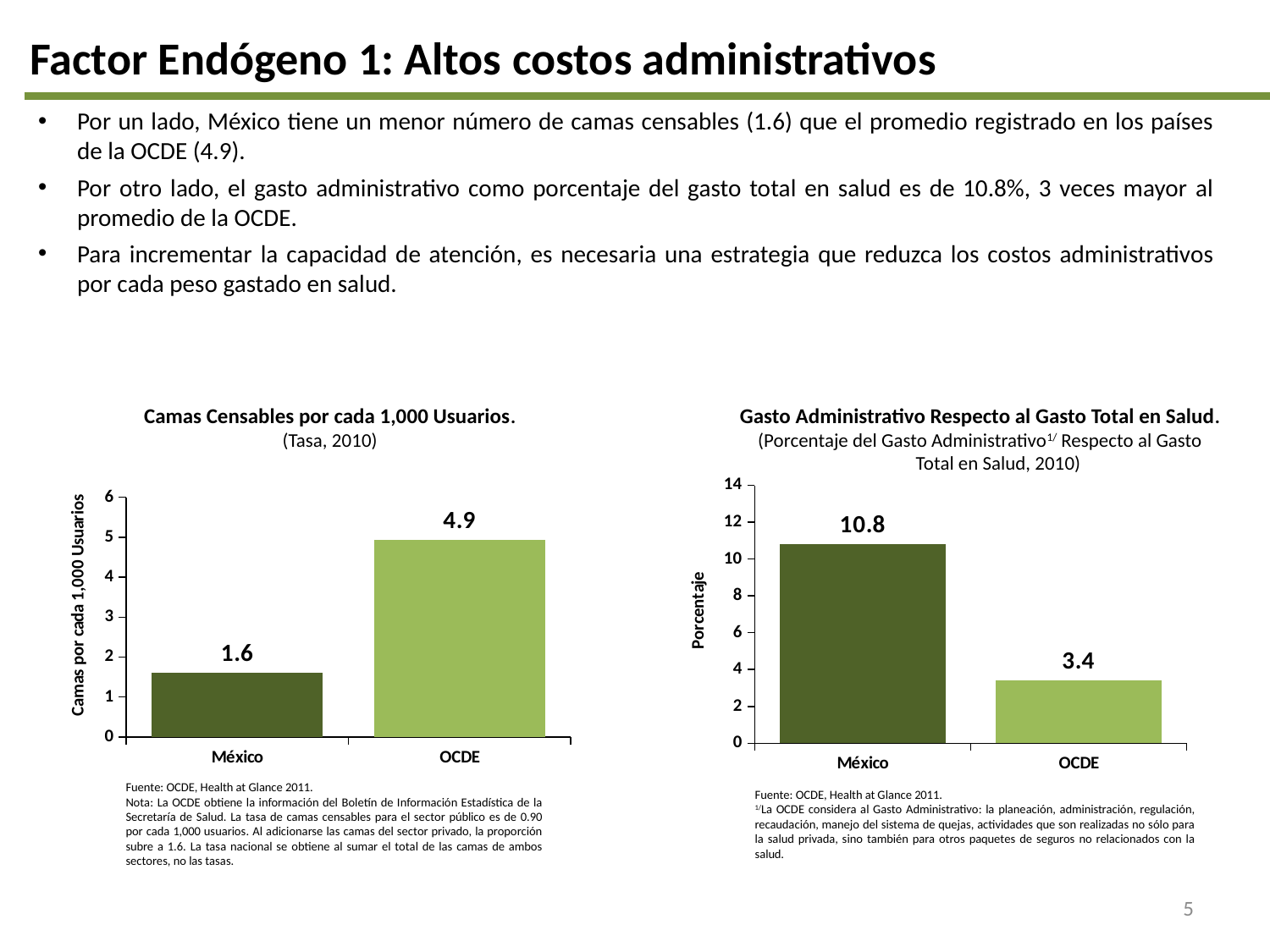
In the 'Gasto Administrativo Respecto al Gasto Total en Salud' chart, which category has the lowest value? OCDE What kind of chart is the 'Gasto Administrativo Respecto al Gasto Total en Salud' chart? bar chart In the 'Camas Censables por cada 1,000 Usuarios' chart, what is the value for OCDE? 4.9 How many categories are shown in the 'Camas Censables por cada 1,000 Usuarios' chart? 2 In the 'Gasto Administrativo Respecto al Gasto Total en Salud' chart, is the value for México larger or smaller than the value for OCDE? larger In the 'Camas Censables por cada 1,000 Usuarios' chart, which category has the highest value? OCDE In the 'Gasto Administrativo Respecto al Gasto Total en Salud' chart, what is the value for OCDE? 3.4 What is the y-axis label of the 'Gasto Administrativo Respecto al Gasto Total en Salud' chart? Porcentaje In the 'Gasto Administrativo Respecto al Gasto Total en Salud' chart, what is the difference between the México and OCDE values? 7.4 In the 'Camas Censables por cada 1,000 Usuarios' chart, what is the difference between the OCDE and México values? 3.3 In the 'Camas Censables por cada 1,000 Usuarios' chart, what is the value for México? 1.6 In the 'Gasto Administrativo Respecto al Gasto Total en Salud' chart, what is the value for México? 10.8